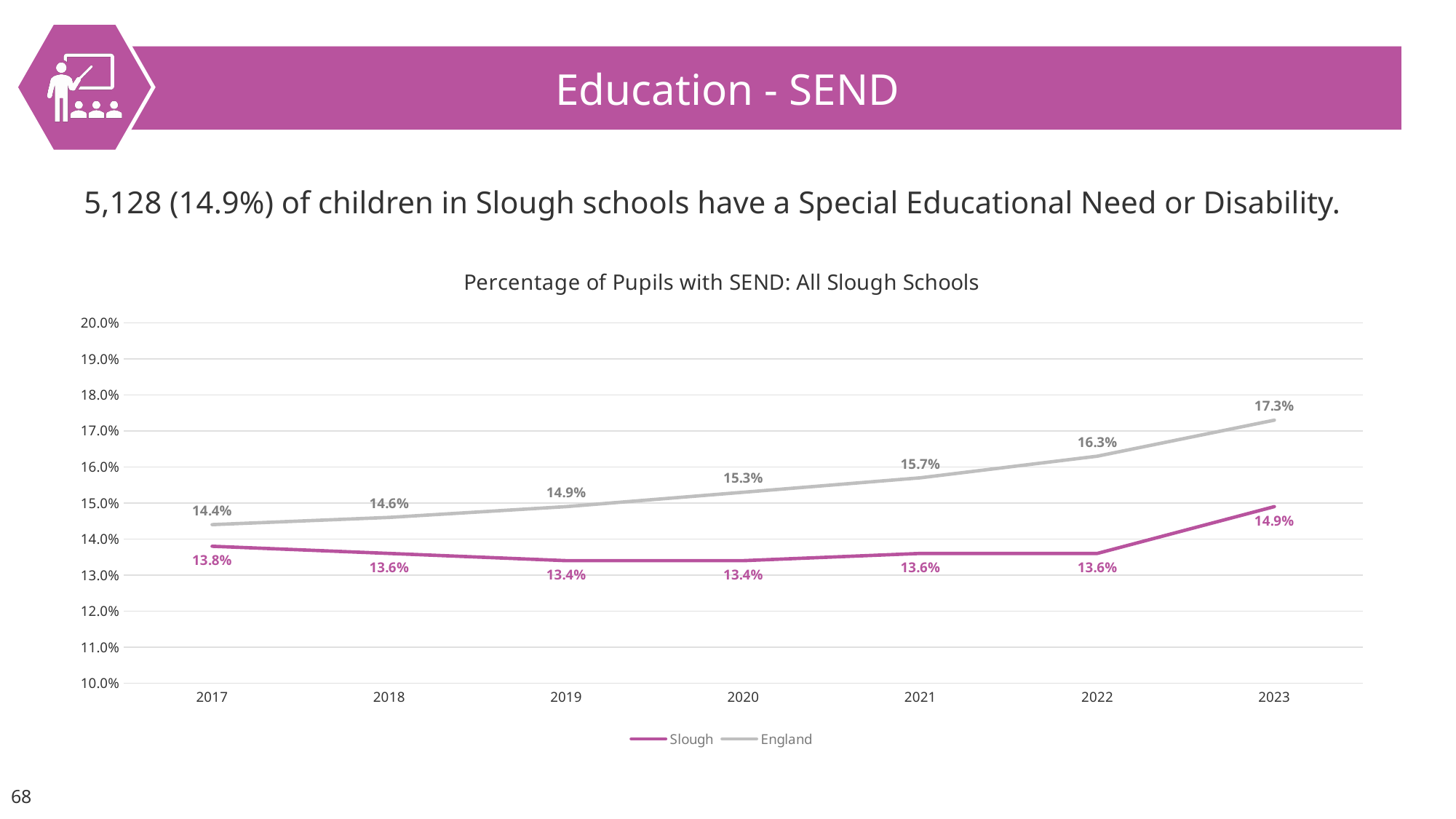
What kind of chart is this? line chart In which year is the England value highest? 2023 What is the England value for 2017? 14.4% How many years are shown on the x axis? 7 How many series does the legend list? 2 Does the England series rise or fall from 2017 to 2023? rise Which is larger in 2020, the Slough value or the England value? England What is the England value for 2021? 15.7% What is the Slough value for 2023? 14.9% What is the Slough value for 2019? 13.4% In which year is the Slough value highest? 2023 What is the difference between the England and Slough values in 2023? 2.4%